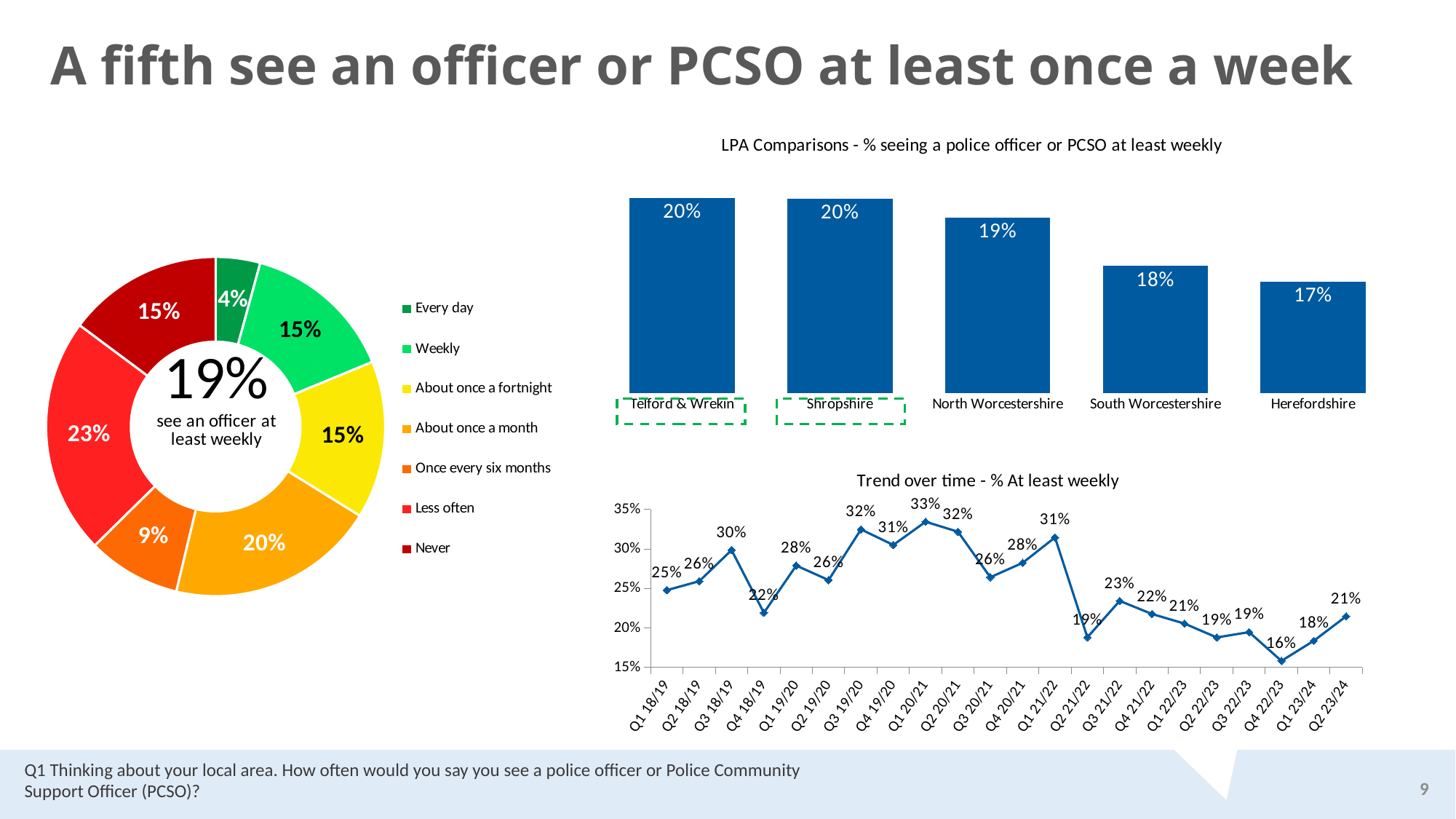
In the Trend over time line chart, what is the value for Q1 20/21? 33% In the donut chart on the left, which category has the smallest share? Every day In the LPA Comparisons bar chart, what is the value for Herefordshire? 17% In the Trend over time line chart, which quarter has the lowest value? Q4 22/23 What type of chart is the 'Trend over time - % At least weekly' chart? Line chart In the LPA Comparisons bar chart, what is the difference between Shropshire and South Worcestershire? 2% In the Trend over time line chart, what is the difference between Q1 21/22 and Q2 21/22? 12% In the donut chart on the left, which is larger: 'About once a month' or 'Once every six months'? About once a month In the donut chart on the left, how many categories does the legend list? 7 In the LPA Comparisons bar chart, how many LPAs are shown? 5 In the donut chart on the left, what share of respondents answered 'Less often'? 23% In the LPA Comparisons bar chart, which LPA has the lowest value? Herefordshire